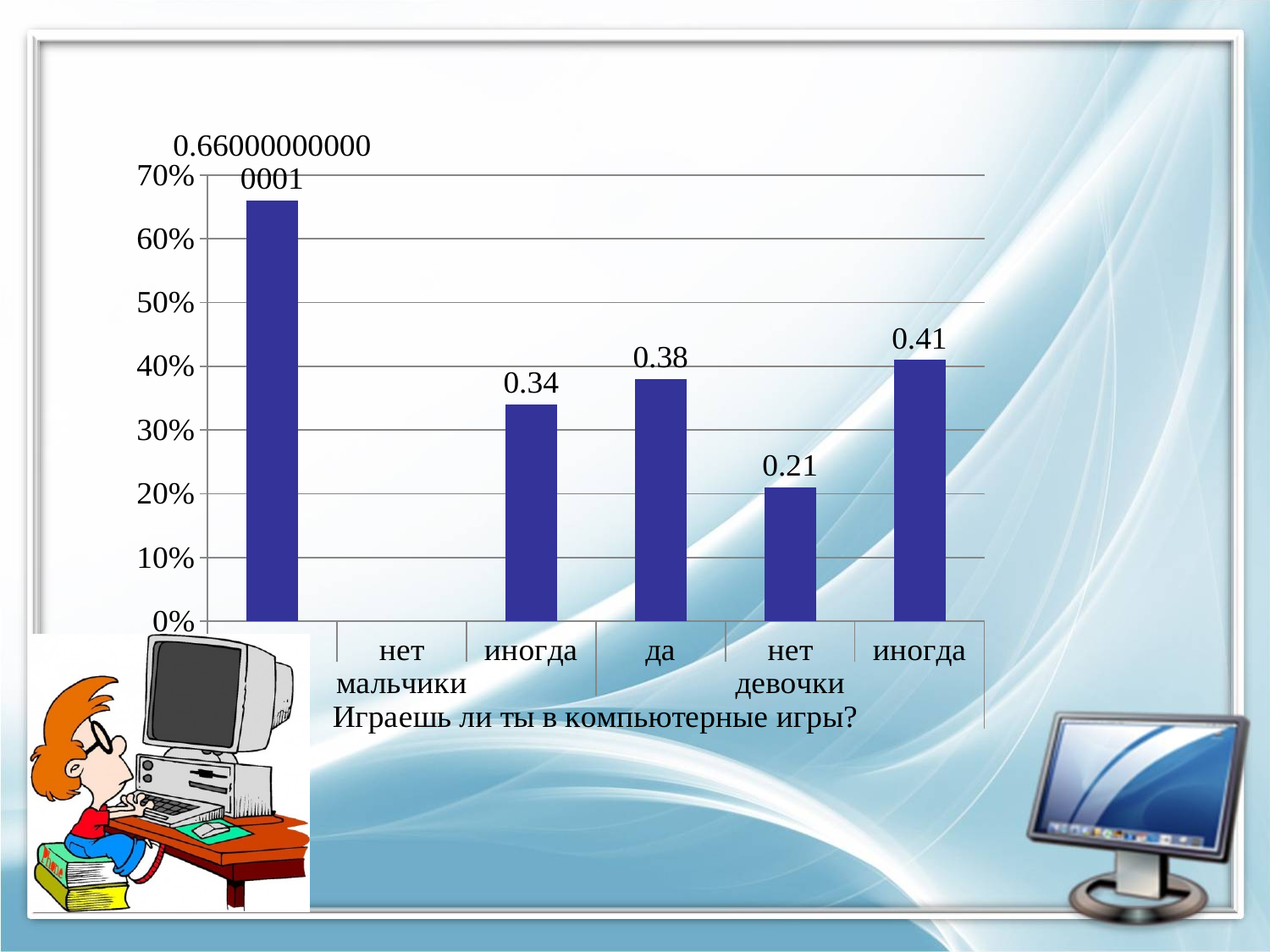
What question is written along the x axis of the chart? Играешь ли ты в компьютерные игры? What type of chart is shown on the slide? bar chart What is the difference between 'иногда' and 'нет' in the 'девочки' group? 0.20 What is the value for 'да' in the 'девочки' group? 0.38 Which is larger: 'да' for девочки or 'иногда' for мальчики? да for девочки How many bars are plotted in the chart? 5 Within the 'девочки' group, which answer has the lowest value? нет What is the value for 'иногда' in the 'девочки' group? 0.41 Is the value for 'нет' in the 'девочки' group greater or less than 30%? less Within the 'девочки' group, which answer has the highest value? иногда What is the value for 'нет' in the 'девочки' group? 0.21 What is the value for 'иногда' in the 'мальчики' group? 0.34